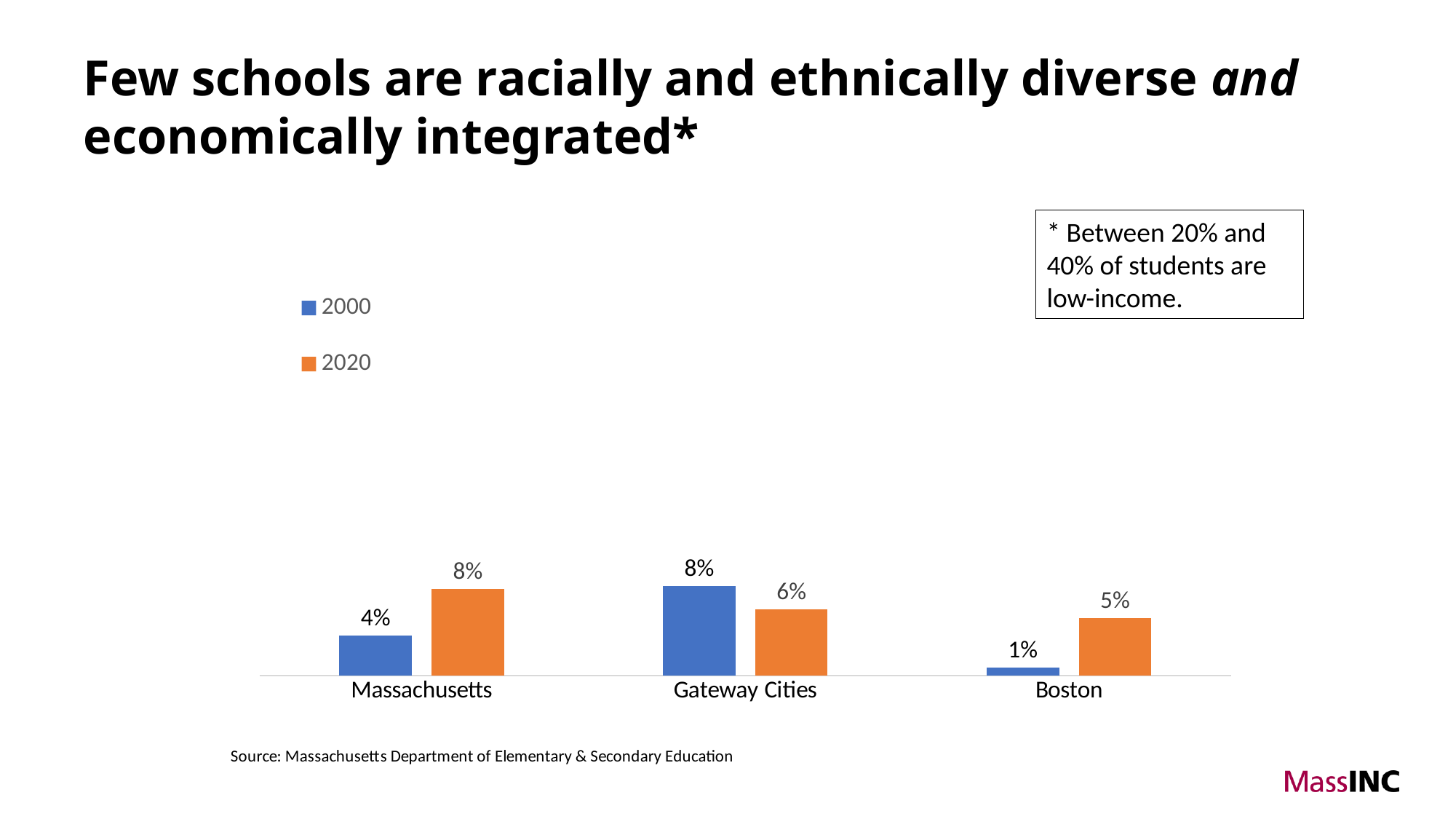
What is the value for Boston in 2020? 5% Which category has the lowest value for 2000? Boston What is the value for Gateway Cities in 2000? 8% Which colour represents the 2020 series? Orange What is the value for Massachusetts in 2000? 4% How many categories are shown on the x axis? 3 Which is larger for Gateway Cities, the 2000 value or the 2020 value? 2000 How many series does the legend list? 2 What is the value for Massachusetts in 2020? 8% What kind of chart is shown on the slide? Bar chart Which category has the highest value for 2020? Massachusetts What is the difference between the 2020 and 2000 values for Boston? 4%